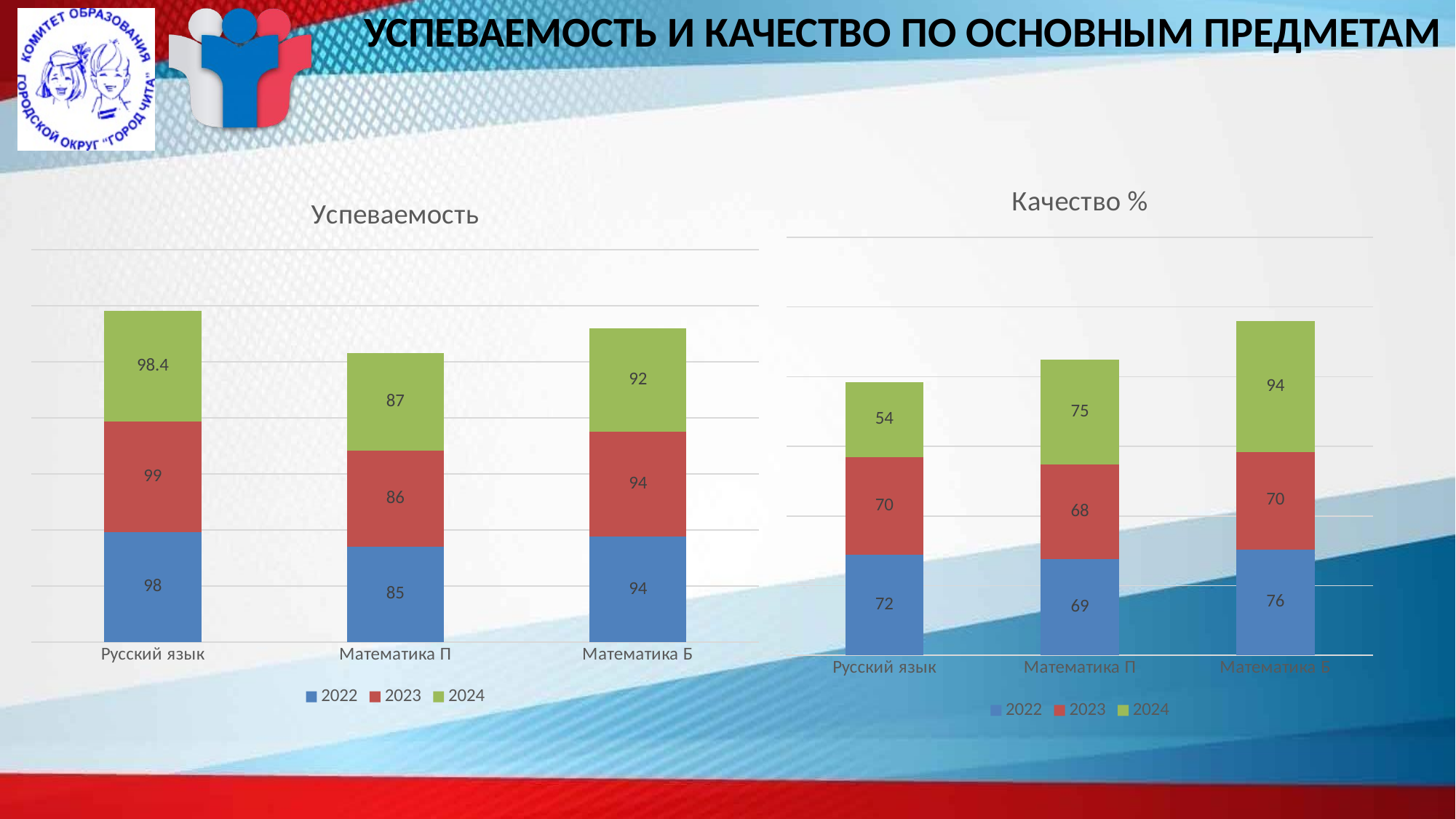
How many series does the legend of the 'Качество %' chart list? 3 How many categories are shown on the x axis of the 'Успеваемость' chart? 3 In the 'Успеваемость' chart, what is the total of the stacked bar for Математика П? 258 In the 'Успеваемость' chart, what is the value for Математика П in 2022? 85 In the 'Качество %' chart, what is the value for Математика Б in 2024? 94 What kind of chart is the 'Качество %' chart? Stacked bar chart In the 'Качество %' chart, which is larger for Русский язык: the 2022 value or the 2024 value? 2022 In the 'Качество %' chart, what is the value for Русский язык in 2023? 70 In the 'Успеваемость' chart, what is the value for Русский язык in 2024? 98.4 In the 'Качество %' chart, what is the difference between the 2024 and 2022 values for Математика Б? 18 In the 'Качество %' chart, which category has the lowest value for 2024? Русский язык In the 'Успеваемость' chart, which category has the lowest value for 2022? Математика П